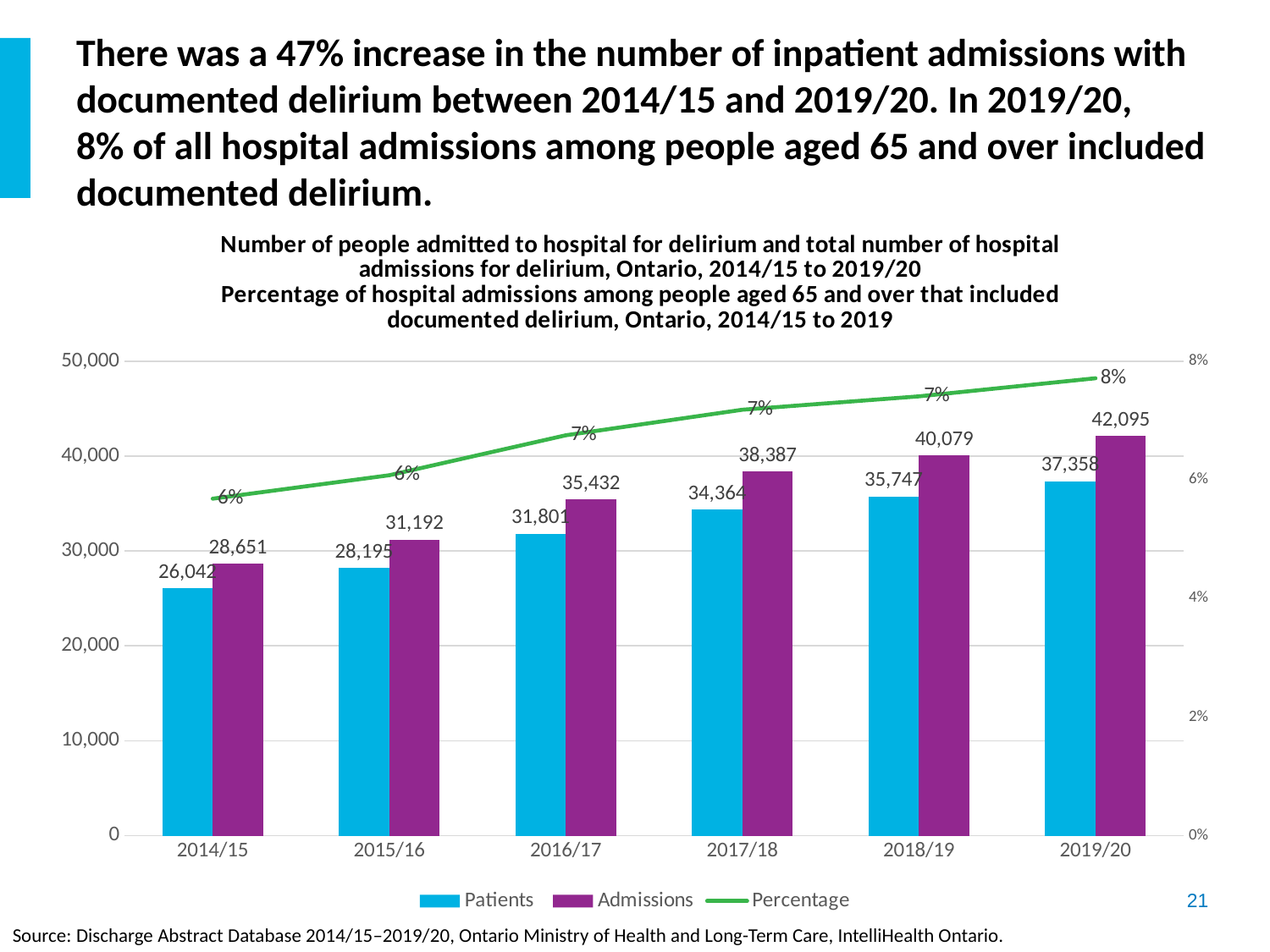
How many years are shown on the x axis? 6 What colour are the Admissions bars? purple What is the difference between Admissions and Patients in 2017/18? 4,023 Which is larger: Patients in 2018/19 or Admissions in 2015/16? Patients in 2018/19 What is the Percentage value shown for 2016/17? 7% How many series does the legend list? 3 Which year has the highest number of Admissions? 2019/20 Do the Admissions values rise or fall from 2014/15 to 2019/20? rise What is the number of Patients in 2014/15? 26,042 Is the Patients value for 2016/17 greater or less than 30,000? greater Which year has the lowest number of Patients? 2014/15 What is the number of Admissions in 2019/20? 42,095